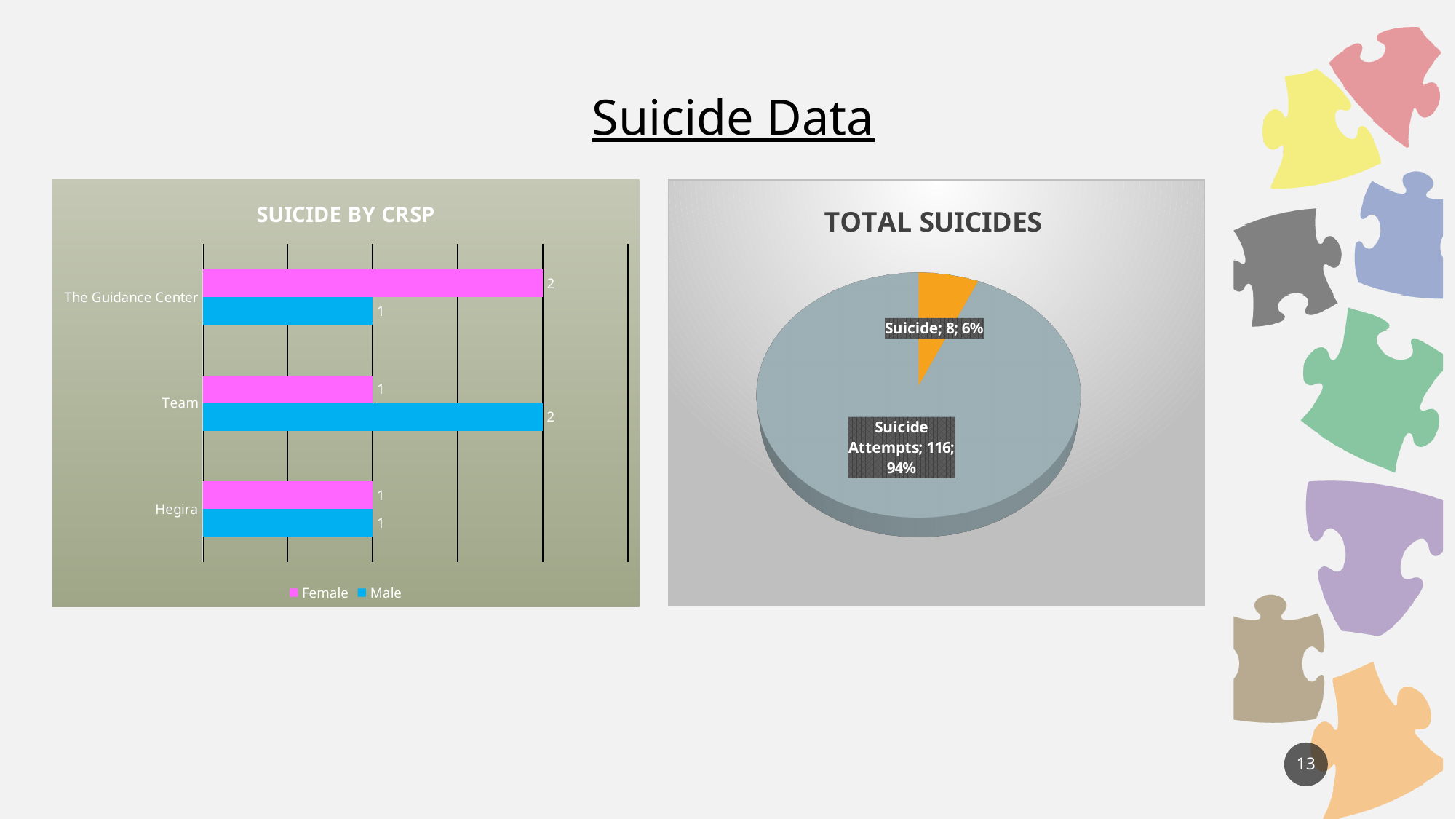
In the 'SUICIDE BY CRSP' chart, is the Female value for Team larger or smaller than the Male value for Team? smaller What kind of chart is 'SUICIDE BY CRSP'? bar chart In the 'SUICIDE BY CRSP' chart, which category has the highest Male value? Team In the 'TOTAL SUICIDES' chart, what share of the pie is Suicide? 6% In the 'SUICIDE BY CRSP' chart, what is the Male value for Hegira? 1 In the 'SUICIDE BY CRSP' chart, what is the Female value for The Guidance Center? 2 In the 'SUICIDE BY CRSP' chart, what is the Male value for Team? 2 In the 'TOTAL SUICIDES' chart, what value is shown for Suicide Attempts? 116 In the 'SUICIDE BY CRSP' chart, what is the difference between the Female and Male values for The Guidance Center? 1 In the 'SUICIDE BY CRSP' chart, which category has the highest Female value? The Guidance Center How many series does the legend of the 'SUICIDE BY CRSP' chart list? 2 How many categories are shown in the 'SUICIDE BY CRSP' chart? 3